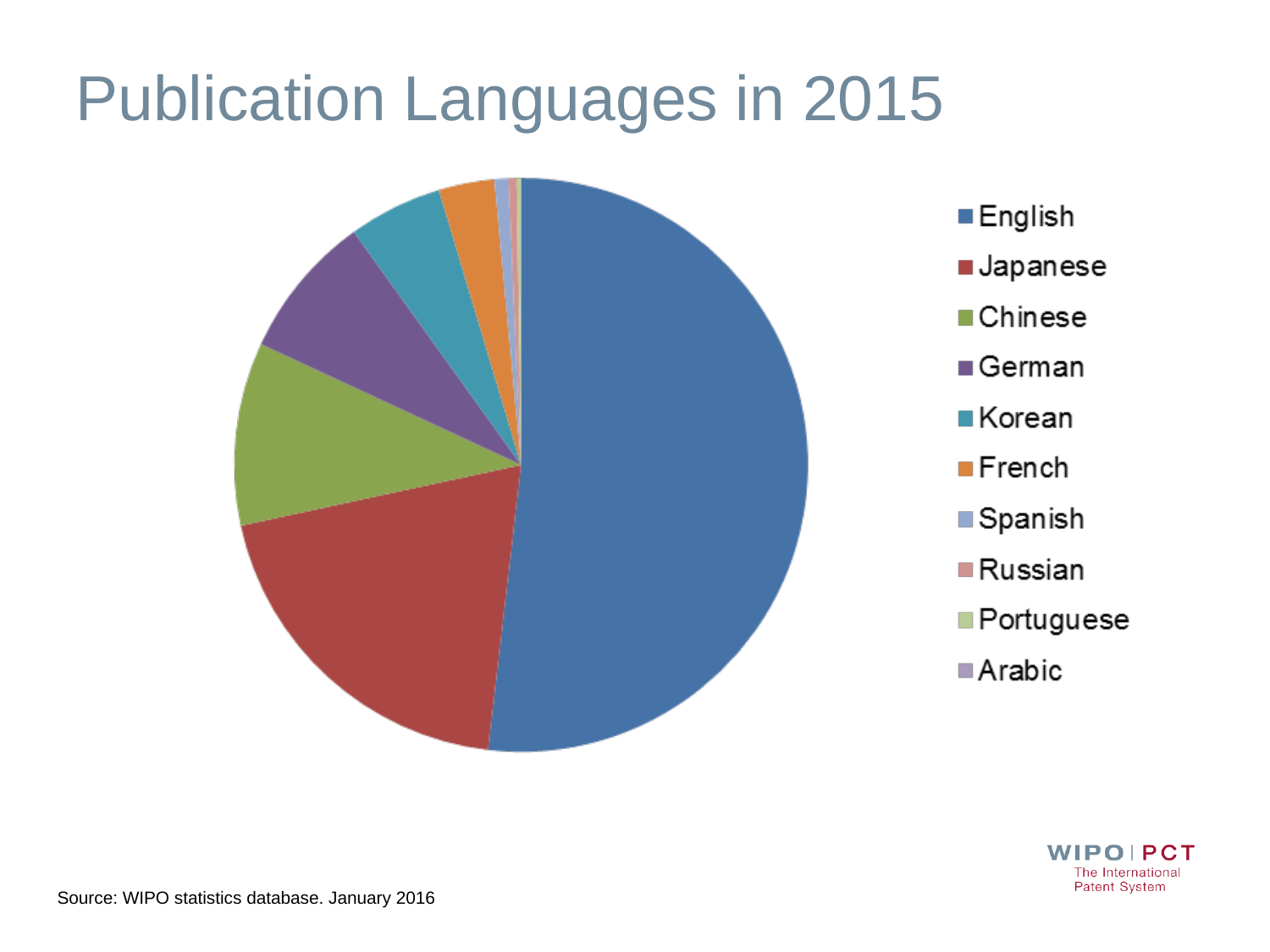
Which slice is larger, Korean or French? Korean What is the title of the slide containing the pie chart? Publication Languages in 2015 Which language is listed last in the legend of the pie chart? Arabic Which slice is larger, Japanese or Chinese? Japanese Which language has the largest slice of the pie? English Which slice is larger, French or Spanish? French Which language has the second-largest slice of the pie? Japanese How many languages are listed in the legend of the pie chart? 10 What kind of chart is shown on the slide? pie chart